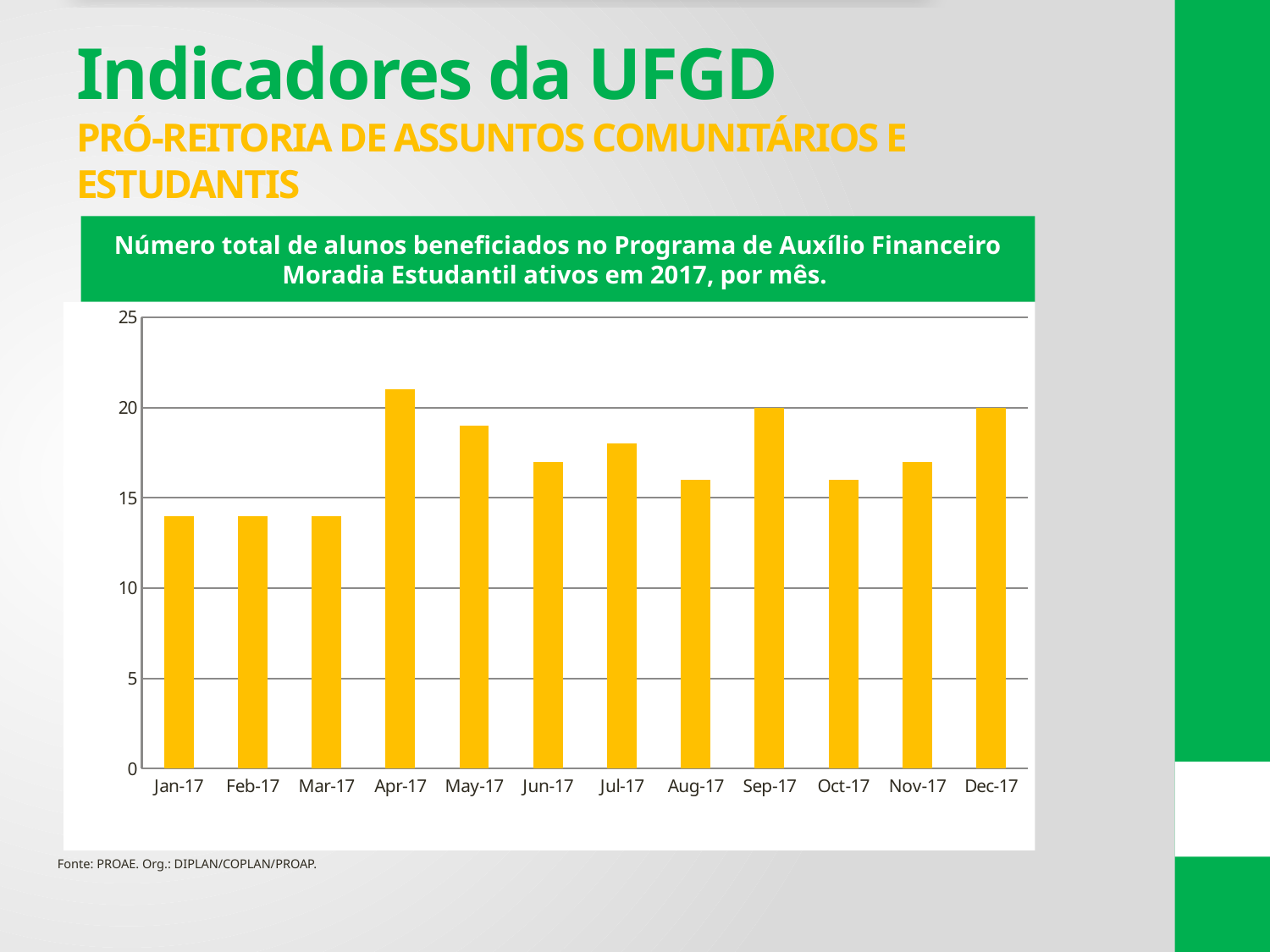
Is the value for Mar-17 greater or less than 15? less What is the title of the chart? Número total de alunos beneficiados no Programa de Auxílio Financeiro Moradia Estudantil ativos em 2017, por mês. Is the value for Jul-17 greater or less than 20? less What is the value for Dec-17? 20 What is the value for Sep-17? 20 How many months are shown on the x axis of the chart? 12 What kind of chart is shown on the slide? bar chart Do the values rise or fall from Jan-17 to Apr-17? rise Is the value for Apr-17 greater or less than 20? greater Which is larger, the value for Apr-17 or the value for Jan-17? Apr-17